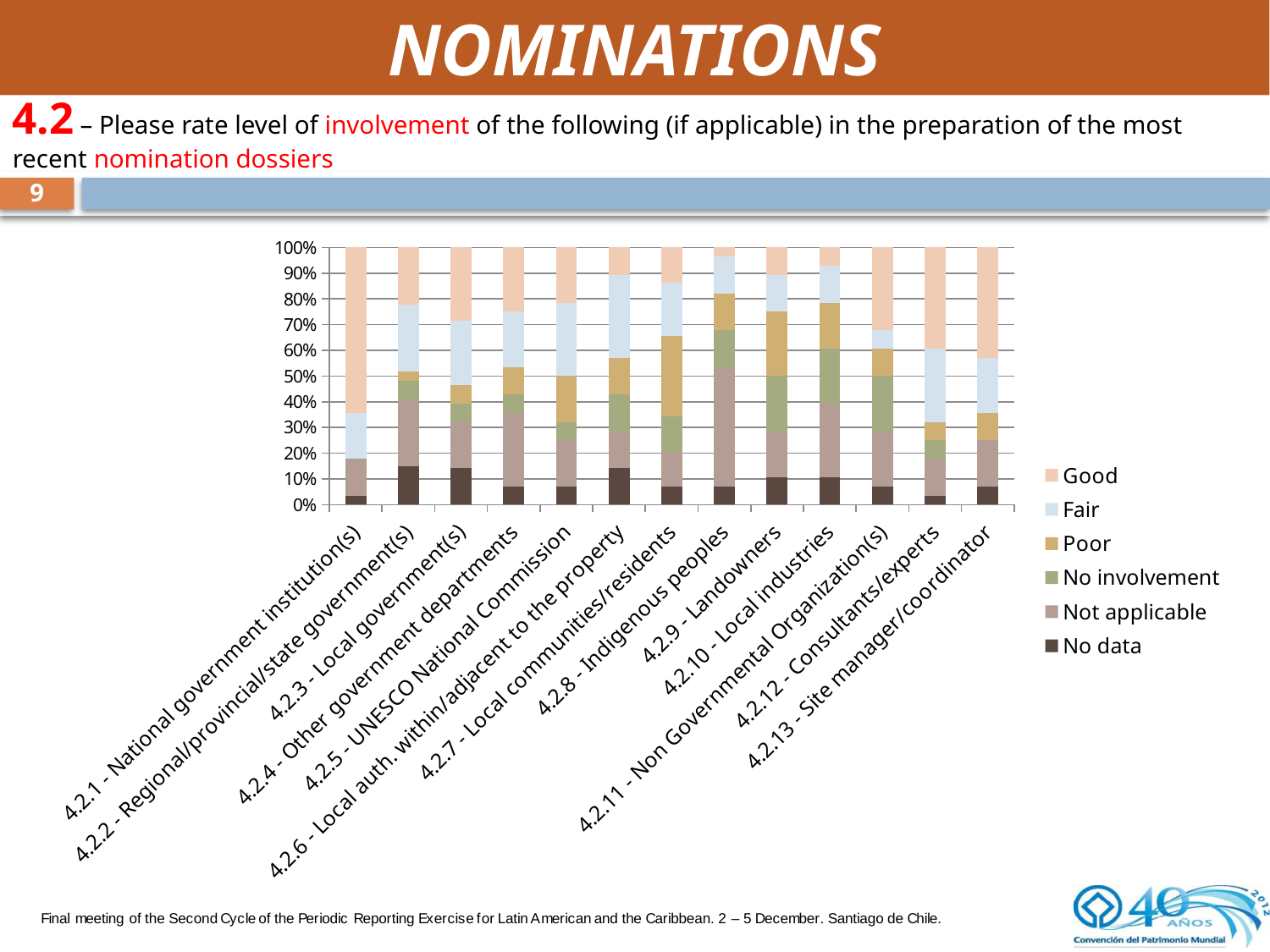
Which series is listed first (at the top) in the legend? Good Is the 'No data' share for 4.2.1 - National government institution(s) greater or less than 10%? less Which category has the largest 'Good' share? 4.2.1 - National government institution(s) Which series is listed last (at the bottom) in the legend? No data What kind of chart is shown on the slide? Stacked bar chart Which has the larger 'No data' share: 4.2.2 - Regional/provincial/state government(s) or 4.2.1 - National government institution(s)? 4.2.2 - Regional/provincial/state government(s) Is the 'Good' share for 4.2.1 - National government institution(s) greater or less than 50%? greater Which has the larger 'Good' share: 4.2.12 - Consultants/experts or 4.2.6 - Local auth. within/adjacent to the property? 4.2.12 - Consultants/experts How many series does the legend list? 6 How many categories (questions 4.2.1 to 4.2.13) are plotted on the x axis? 13 Is the 'Not applicable' share for 4.2.8 - Indigenous peoples greater or less than 50%? less Which category has the largest 'Not applicable' share? 4.2.8 - Indigenous peoples